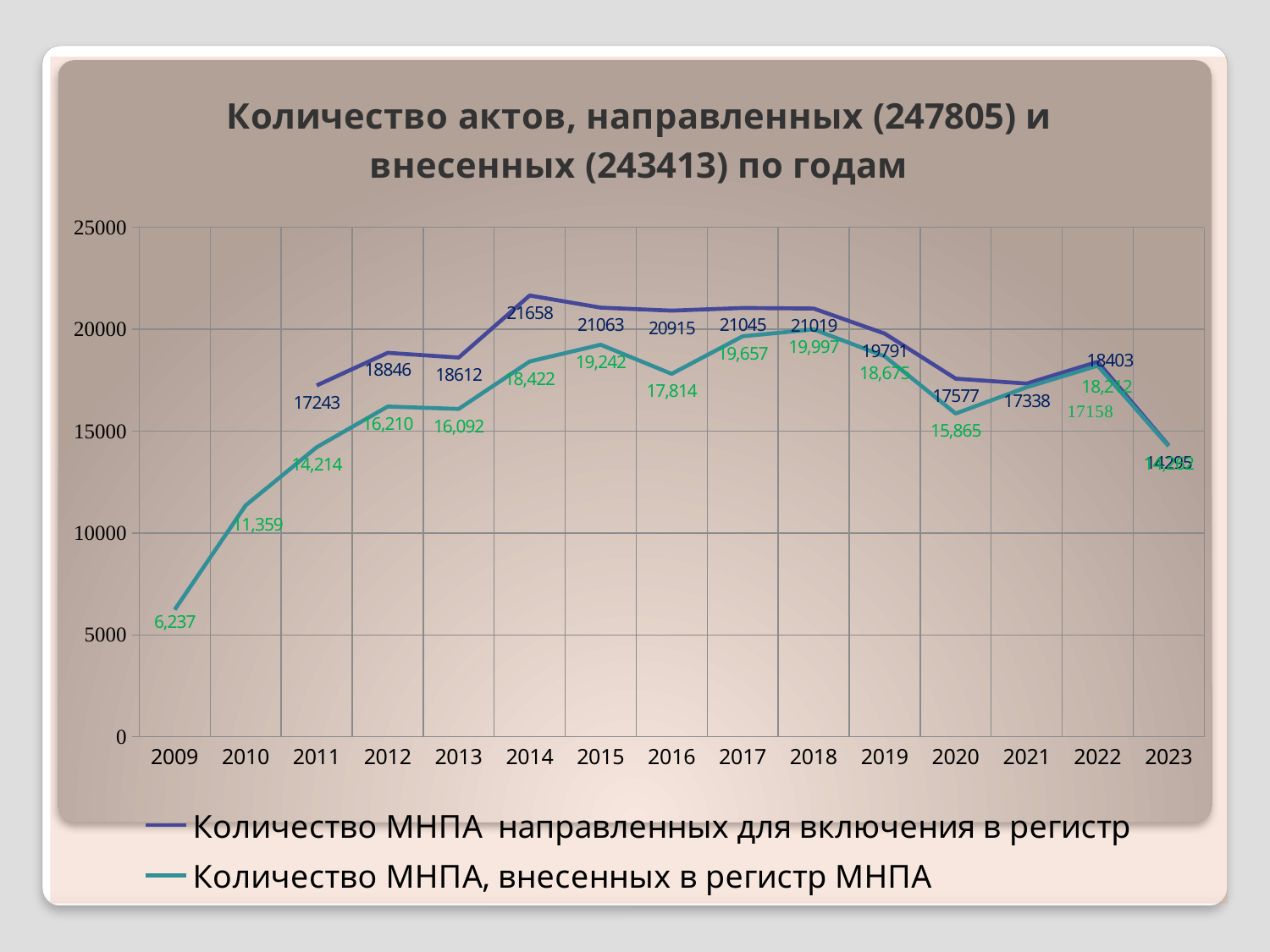
What is the value for 2009 in the series 'Количество МНПА, внесенных в регистр МНПА'? 6,237 What type of chart is shown on the slide? Line chart Does the series 'Количество МНПА, внесенных в регистр МНПА' rise or fall from 2009 to 2015? Rise In which year does the series 'Количество МНПА, внесенных в регистр МНПА' have its lowest value? 2009 How many series does the legend list? 2 What is the value for 2014 in the series 'Количество МНПА направленных для включения в регистр'? 21658 How many years are shown on the x axis? 15 Which is larger for the series 'Количество МНПА, внесенных в регистр МНПА': the value for 2015 or the value for 2016? 2015 In which year does the series 'Количество МНПА направленных для включения в регистр' reach its highest value? 2014 What is the difference between the two series in 2014 (21658 and 18,422)? 3236 What is the value for 2018 in the series 'Количество МНПА, внесенных в регистр МНПА'? 19,997 Is the value for 2010 in the series 'Количество МНПА, внесенных в регистр МНПА' greater or less than 10000? greater